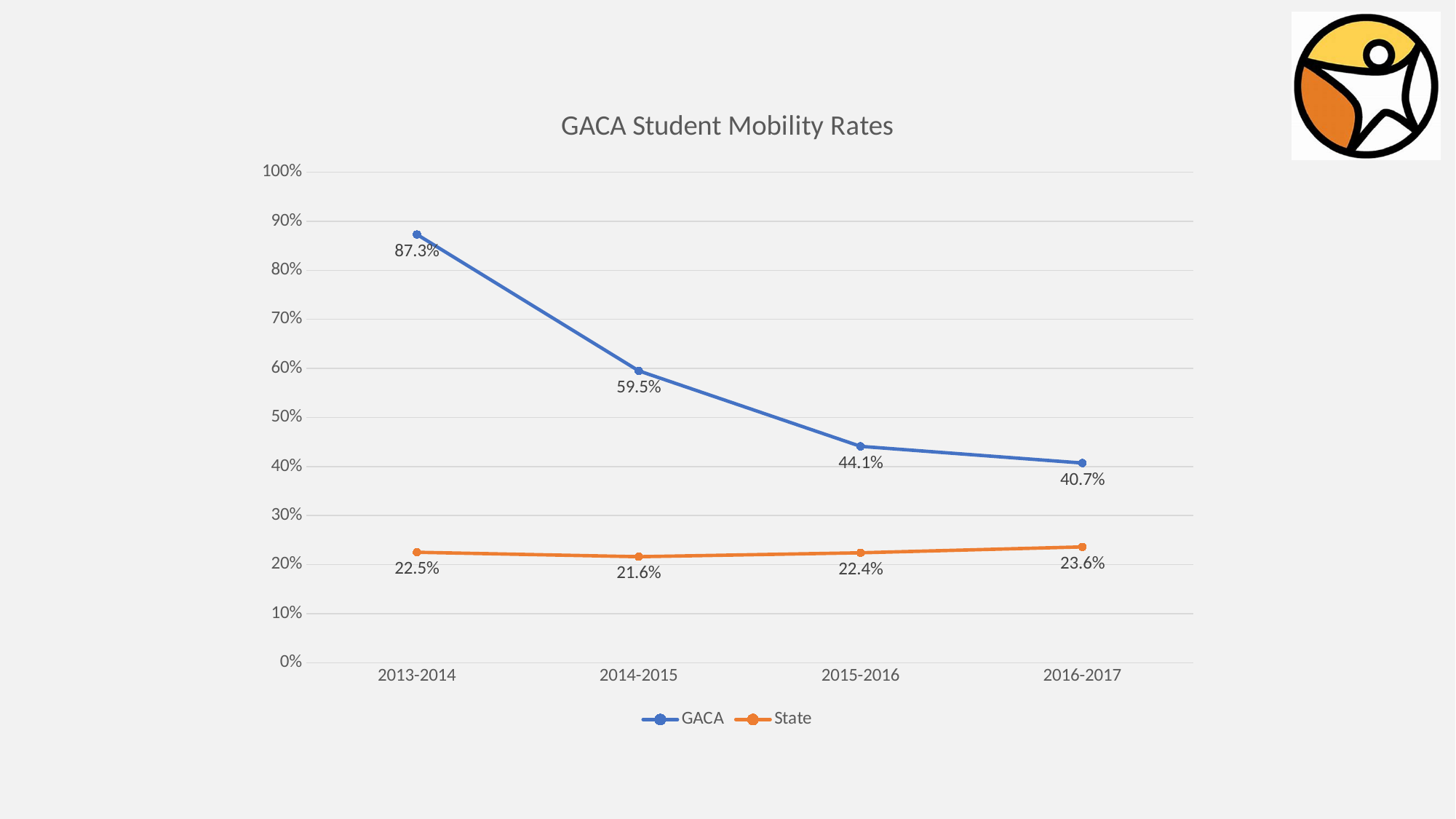
In which year is the State mobility rate lowest? 2014-2015 What is the GACA value for 2015-2016? 44.1% What is the difference between the GACA and State rates in 2016-2017? 17.1% Does the GACA mobility rate rise or fall from 2013-2014 to 2016-2017? Fall How many series does the legend list? 2 Is the GACA value for 2014-2015 greater or less than 50%? greater What is the GACA student mobility rate for 2013-2014? 87.3% In which year is the GACA mobility rate highest? 2013-2014 What kind of chart is shown on the slide? Line chart How many school years are shown on the x axis? 4 What is the State student mobility rate for 2016-2017? 23.6% Which is larger in 2014-2015, the GACA rate or the State rate? GACA